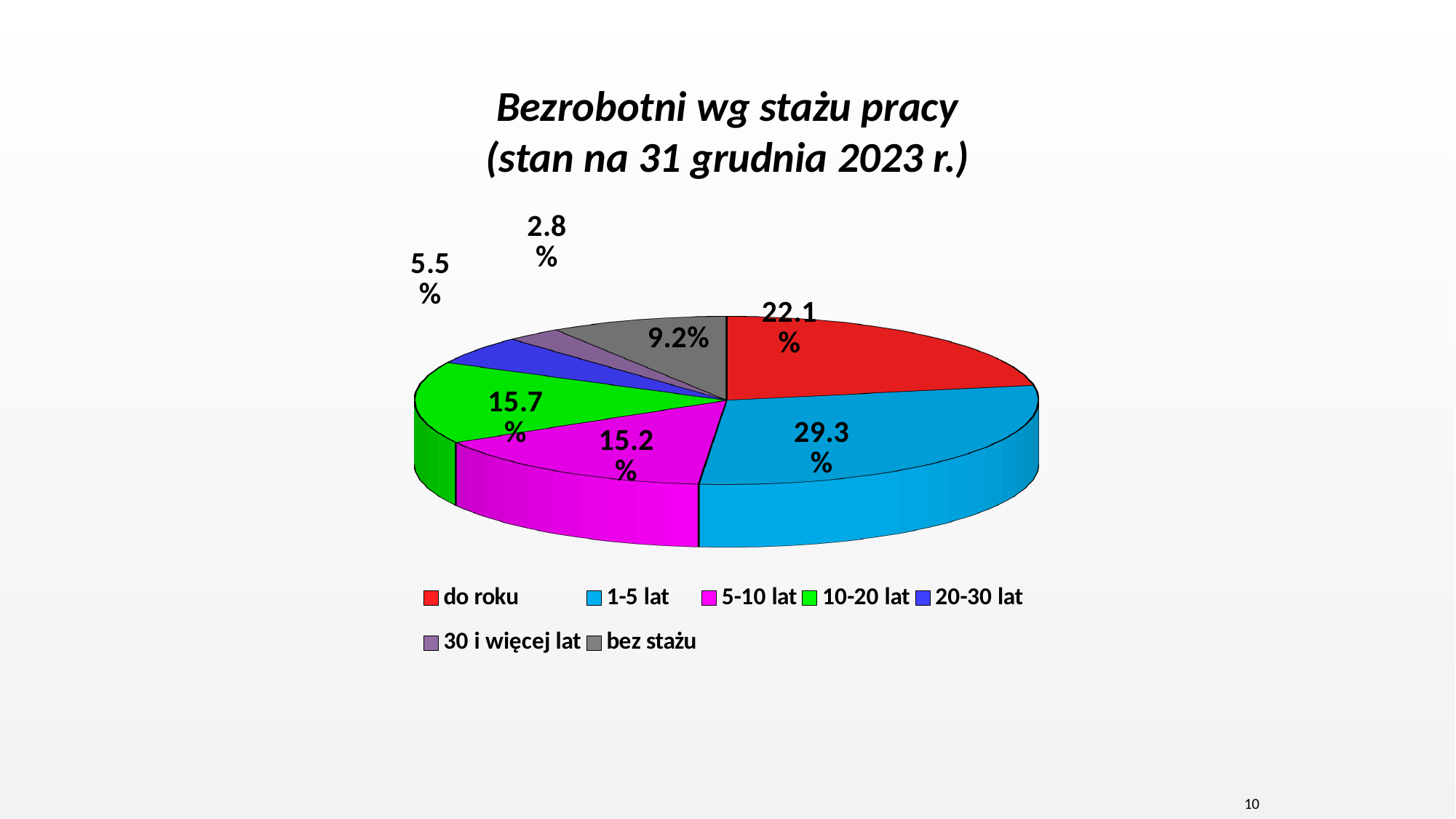
What is the share for "10-20 lat"? 15.7% What is the share for "bez stażu"? 9.2% What is the share for "1-5 lat"? 29.3% What is the share for "30 i więcej lat"? 2.8% How many categories does the legend list? 7 Which category has the smallest share of the pie? 30 i więcej lat What is the title of the chart? Bezrobotni wg stażu pracy (stan na 31 grudnia 2023 r.) What is the difference in percentage points between "1-5 lat" and "do roku"? 7.2 Which category has the largest share of the pie? 1-5 lat Which is larger, the share for "5-10 lat" or the share for "bez stażu"? 5-10 lat What is the share for "do roku"? 22.1% What kind of chart is shown on the slide? pie chart